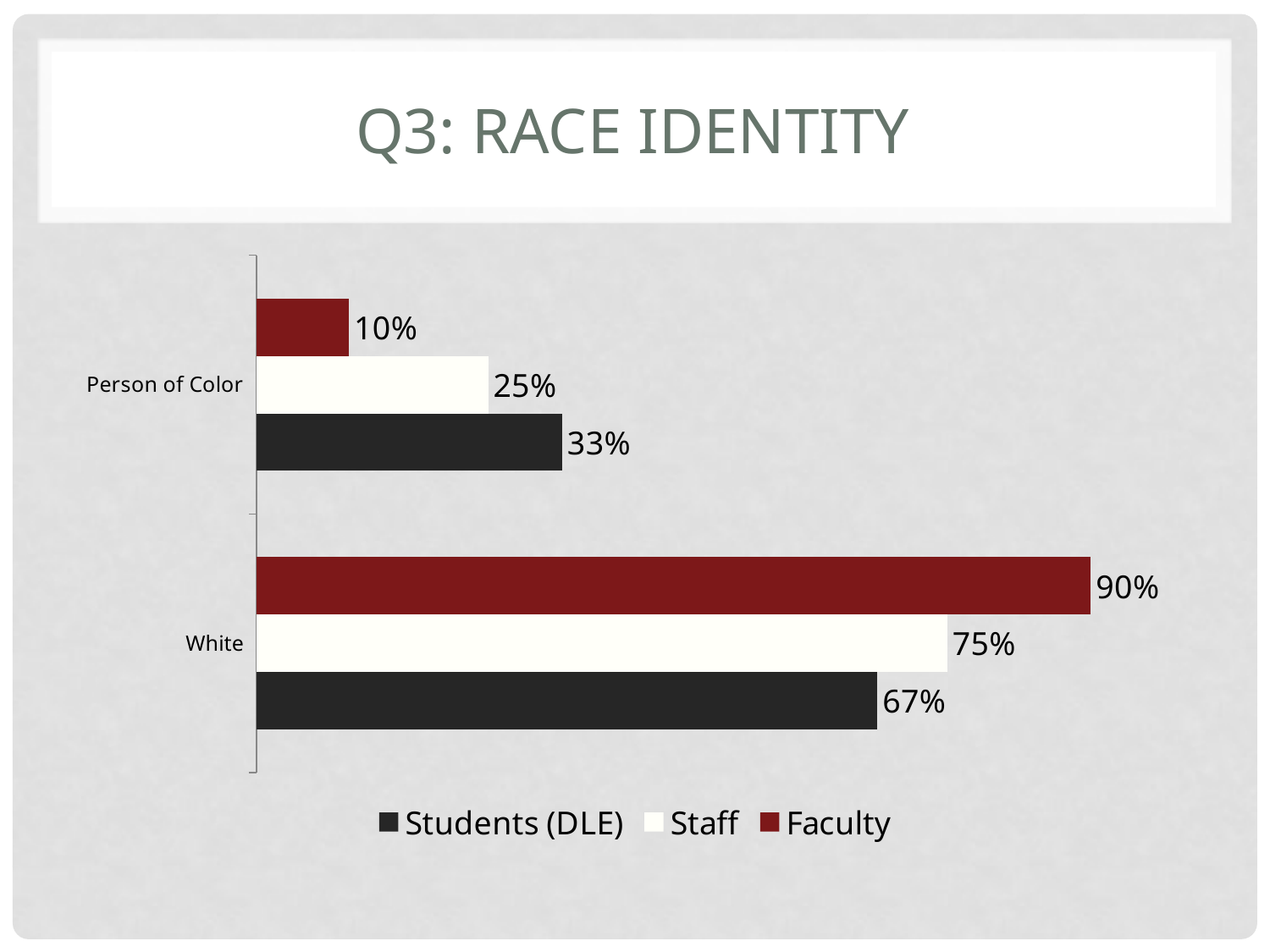
What percentage of Students (DLE) identify as Person of Color? 33% What percentage of Staff identify as White? 75% What kind of chart is shown on the slide? Bar chart What percentage of Faculty identify as White? 90% What is the difference between the Faculty and Students (DLE) percentages for White? 23% Which group has the highest percentage identifying as White? Faculty Which group has the lowest percentage identifying as Person of Color? Faculty Which is larger: the Staff percentage for Person of Color or the Students (DLE) percentage for Person of Color? Students (DLE) What is the title of the slide containing the chart? Q3: Race Identity What is the difference between the Staff and Faculty percentages for Person of Color? 15% How many series does the legend list? 3 What percentage of Faculty identify as Person of Color? 10%